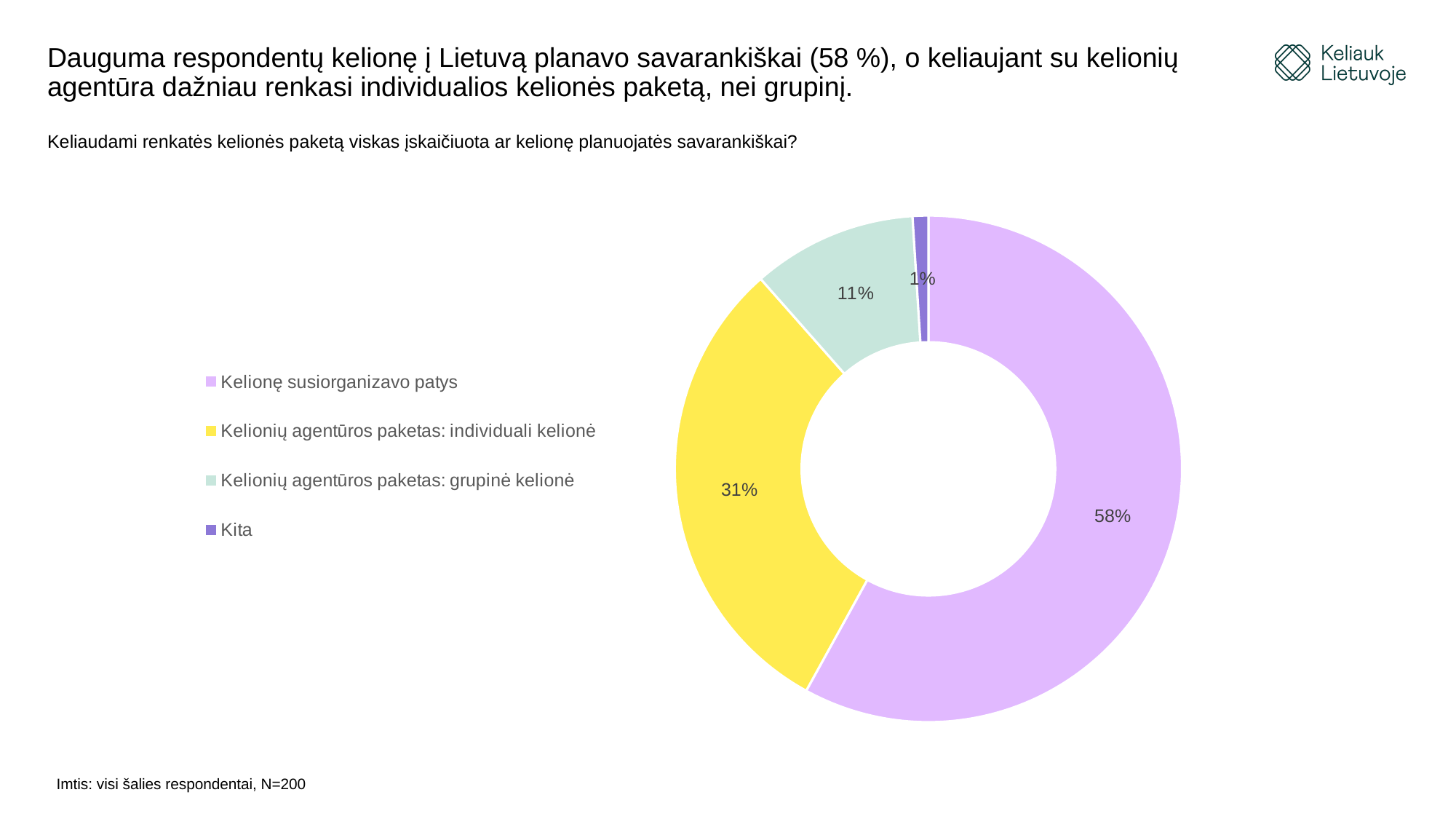
Which is larger: "Kelionių agentūros paketas: individuali kelionė" or "Kelionių agentūros paketas: grupinė kelionė"? Kelionių agentūros paketas: individuali kelionė What is the value shown for "Kita"? 1% What colour is the slice for "Kita"? Purple What is the difference in percentage points between "Kelionę susiorganizavo patys" and "Kelionių agentūros paketas: individuali kelionė"? 27 What share of respondents does the slice "Kelionę susiorganizavo patys" represent? 58% What is the sample size stated at the bottom of the slide? N=200 What is the value shown for "Kelionių agentūros paketas: grupinė kelionė"? 11% What kind of chart is shown on the slide? Pie chart (donut) How many categories are shown in the chart? 4 Which category has the smallest slice of the chart? Kita What is the value shown for "Kelionių agentūros paketas: individuali kelionė"? 31% Which category has the largest slice of the chart? Kelionę susiorganizavo patys